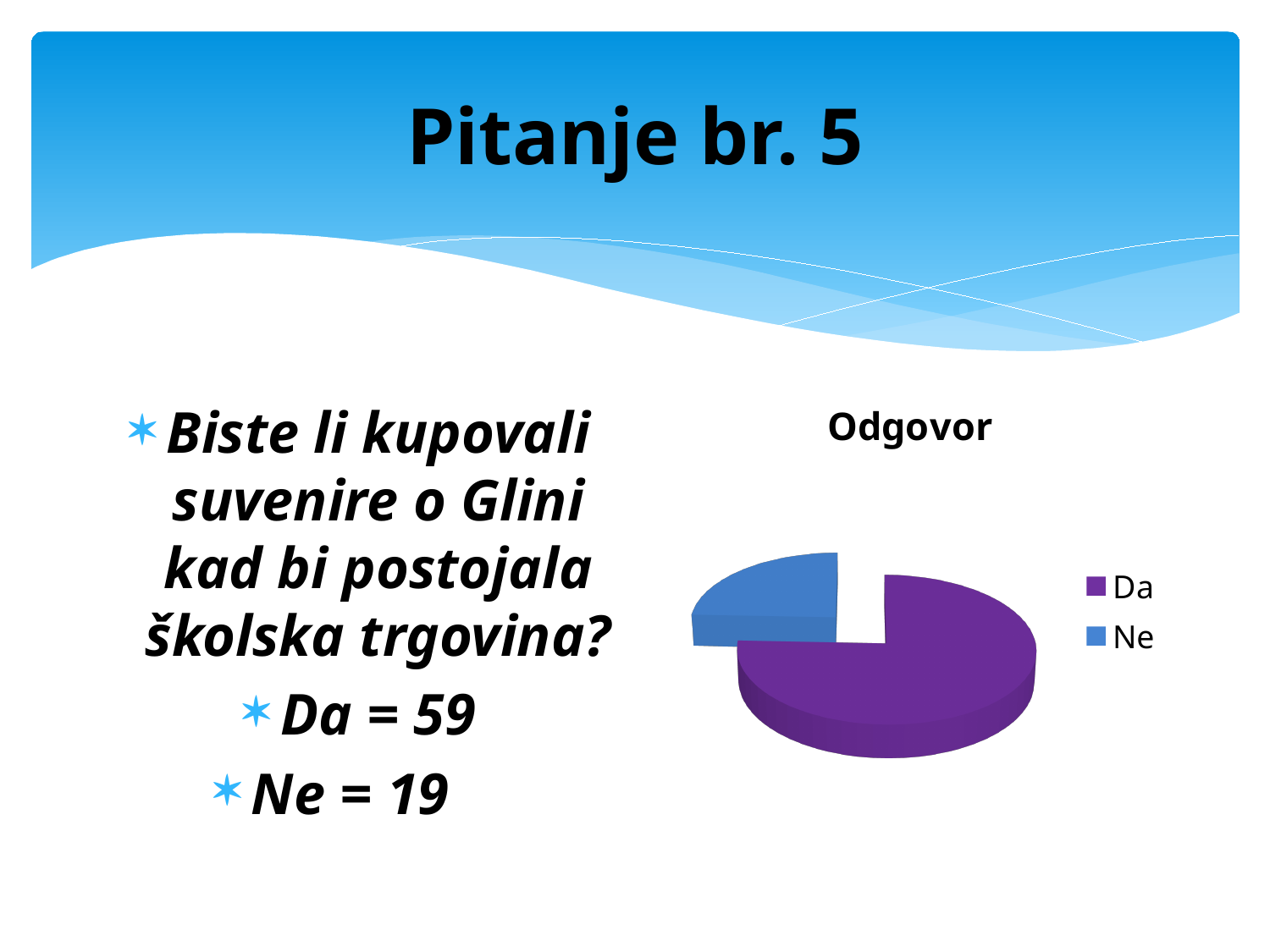
How many entries does the chart legend list? 2 Which answer has the smallest slice in the pie chart? Ne What colour is the Da slice in the pie chart? purple What kind of chart is shown on the slide? pie chart Which answer has the largest slice in the pie chart? Da What is the difference between the values for Da and Ne? 40 What is the value for Da? 59 Which is larger, the value for Da or the value for Ne? Da How many slices does the pie chart have? 2 What is the value for Ne? 19 What is the title of the chart? Odgovor